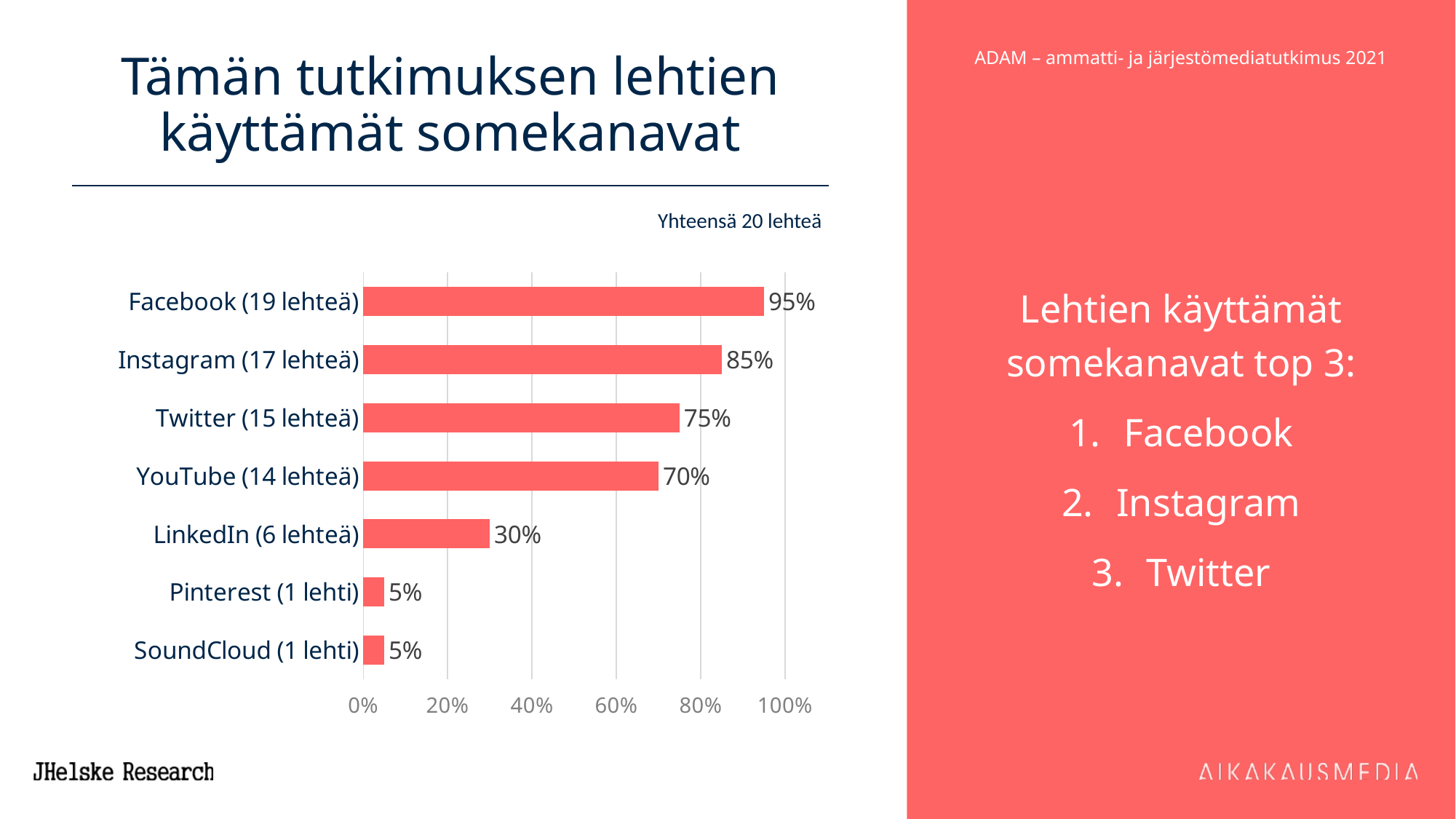
What is the difference between the values for Facebook (19 lehteä) and LinkedIn (6 lehteä)? 65% What is the title of the chart on the slide? Tämän tutkimuksen lehtien käyttämät somekanavat What is the value for LinkedIn (6 lehteä)? 30% What is the difference between the values for Instagram (17 lehteä) and Twitter (15 lehteä)? 10% What is the value for Facebook (19 lehteä)? 95% Which is larger, the value for Twitter (15 lehteä) or the value for YouTube (14 lehteä)? Twitter (15 lehteä) Which category has the highest value? Facebook (19 lehteä) What is the value for Pinterest (1 lehti)? 5% What kind of chart is shown on the slide? bar chart Is the value for Instagram (17 lehteä) greater or less than 80%? greater How many categories are shown in the chart? 7 What is the value for YouTube (14 lehteä)? 70%